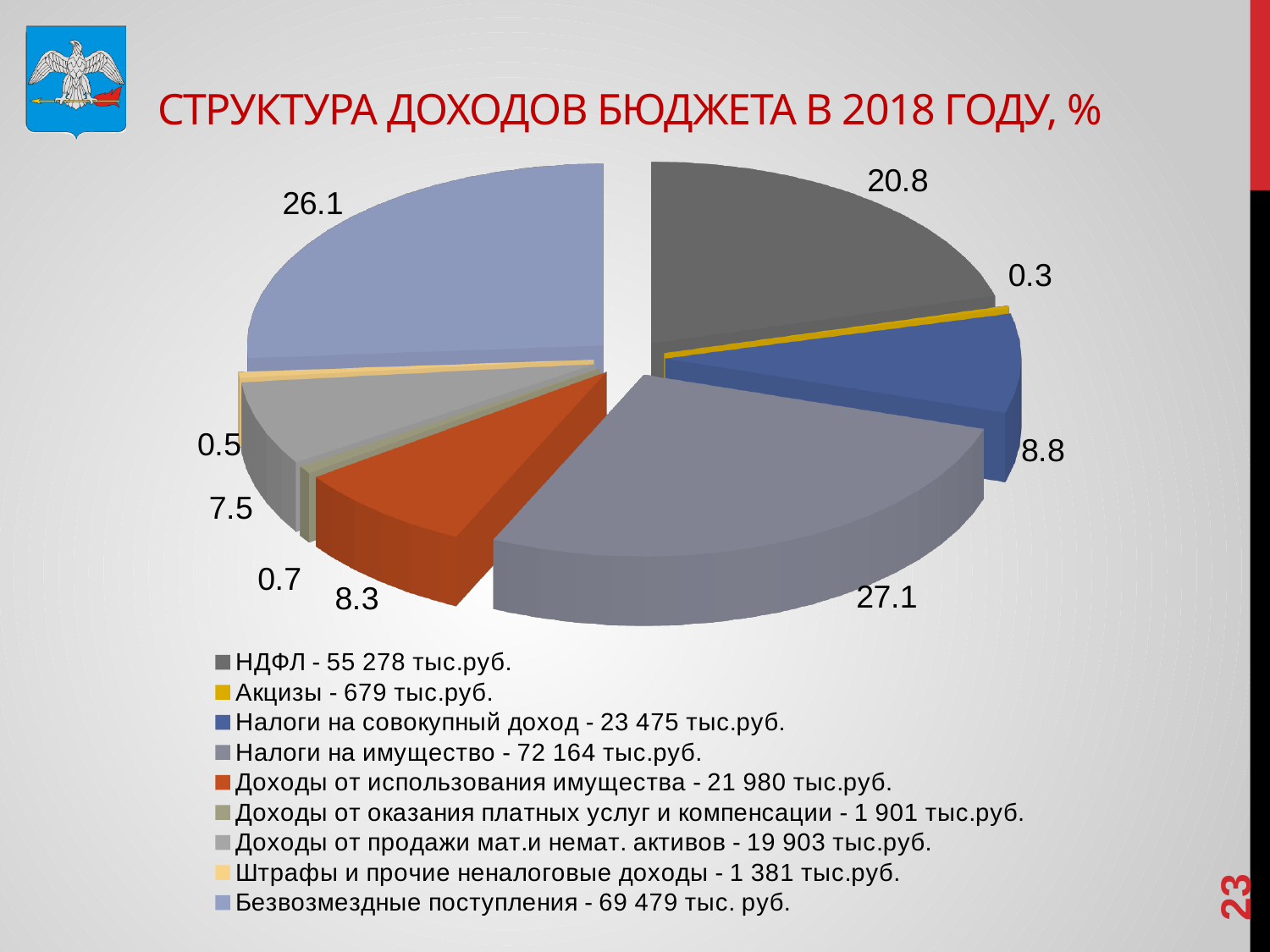
What is the difference in percentage points between Налоги на имущество and Безвозмездные поступления? 1.0 What is the title of the chart? СТРУКТУРА ДОХОДОВ БЮДЖЕТА В 2018 ГОДУ, % Which is larger: the share for Налоги на совокупный доход or the share for Доходы от использования имущества? Налоги на совокупный доход According to the legend, what amount in thousand rubles is given for Акцизы? 679 тыс.руб. Which category has the smallest share of the pie? Акцизы What percentage share is shown for Налоги на имущество? 27.1 What percentage share is shown for Безвозмездные поступления? 26.1 How many slices does the pie chart have? 9 What percentage share is shown for Доходы от продажи мат.и немат. активов? 7.5 What kind of chart is shown on the slide? pie chart What percentage share is shown for НДФЛ? 20.8 Which category has the largest share of the pie? Налоги на имущество